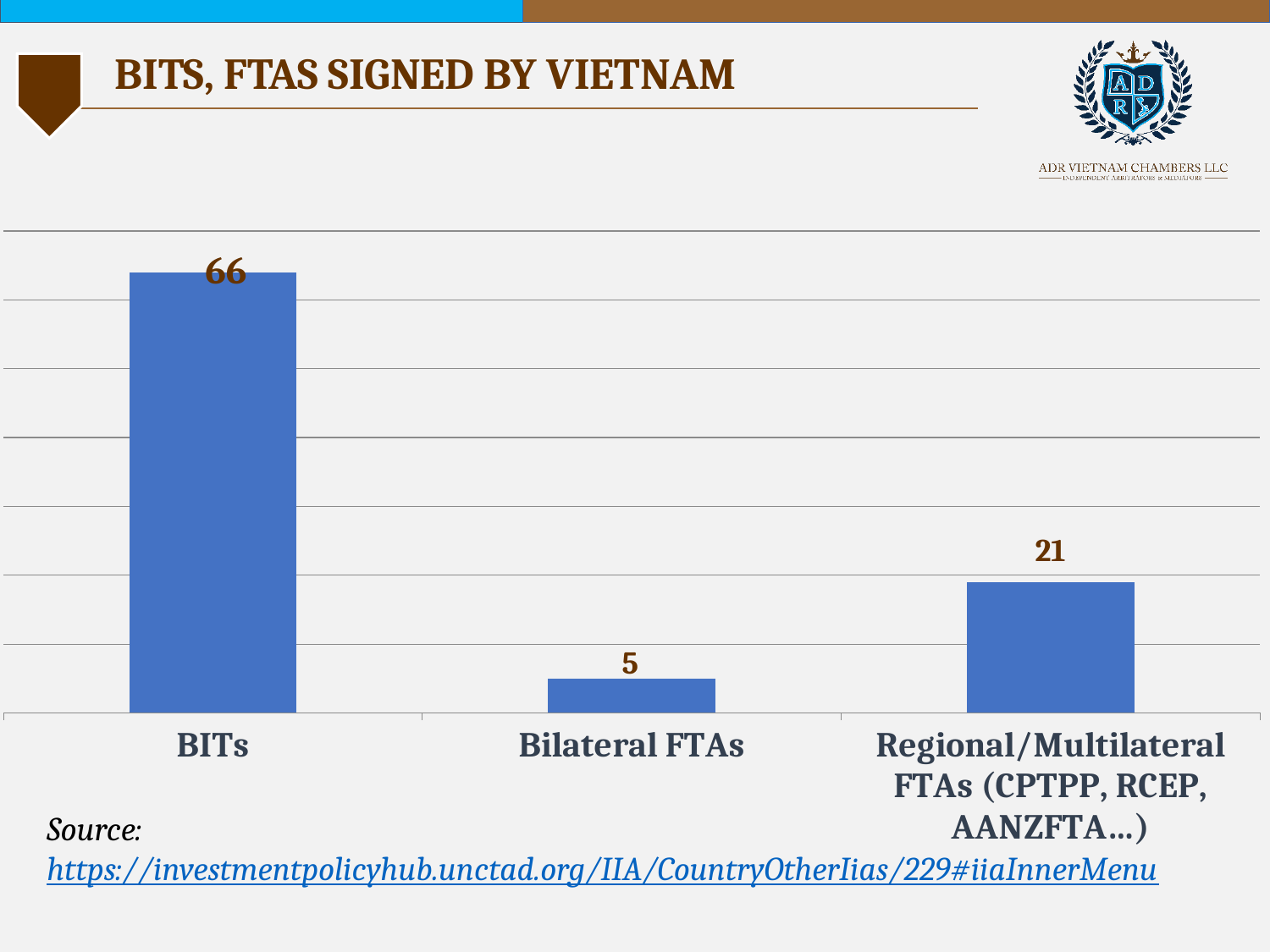
How many categories are shown in the chart? 3 What kind of chart is shown on the slide? Bar chart Which category has the lowest value? Bilateral FTAs What is the difference between the value for BITs and the value for Regional/Multilateral FTAs? 45 What is the title of the slide containing the chart? BITS, FTAS SIGNED BY VIETNAM Which category has the highest value? BITs What is the value for Bilateral FTAs? 5 What is the difference between the value for Regional/Multilateral FTAs and the value for Bilateral FTAs? 16 What is the value for Regional/Multilateral FTAs (CPTPP, RCEP, AANZFTA…)? 21 What is the total of the three values shown in the chart? 92 What is the value for BITs? 66 Which is larger, the value for Bilateral FTAs or the value for Regional/Multilateral FTAs? Regional/Multilateral FTAs